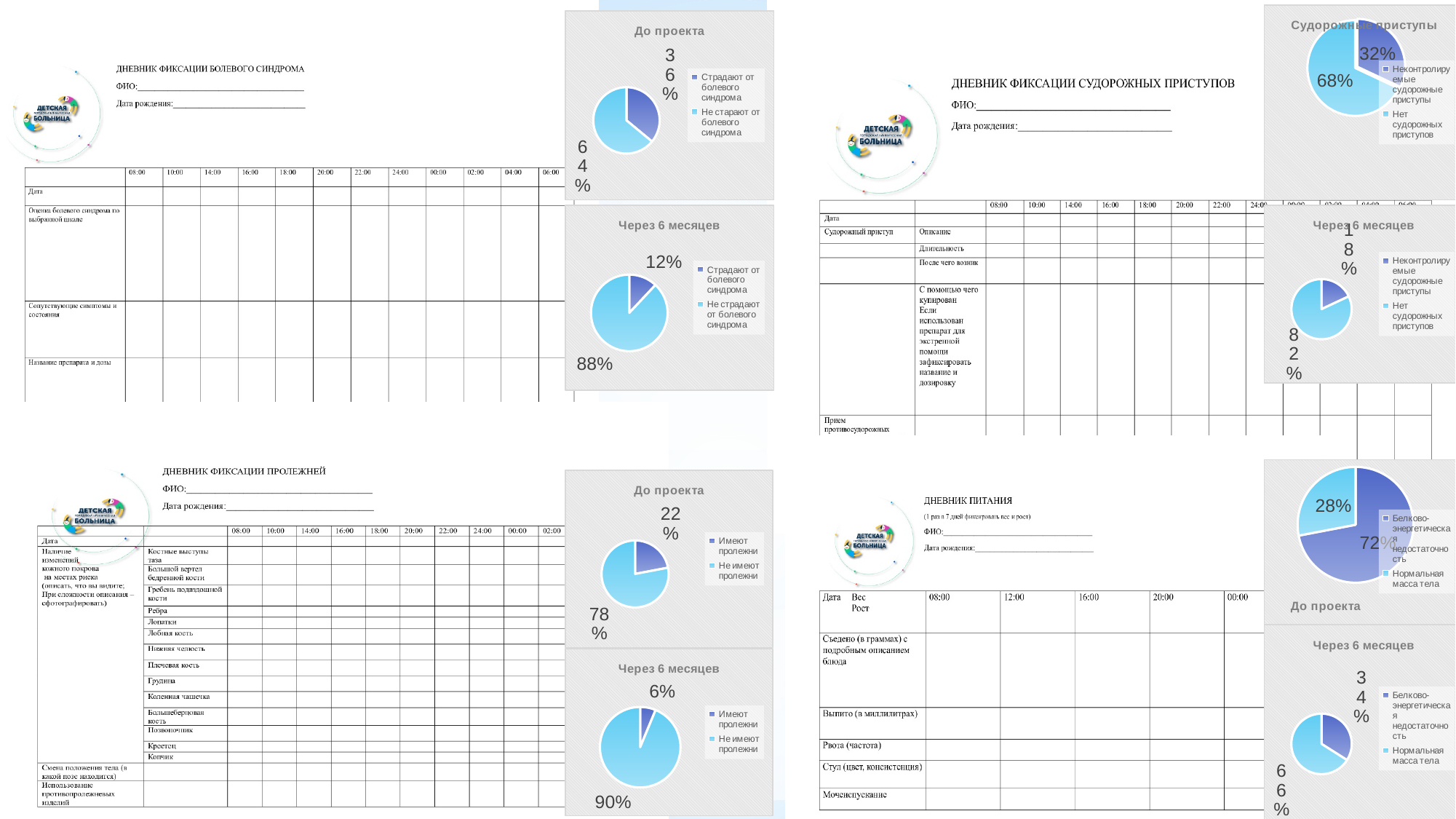
What type of chart is used for the 'Судорожные приступы' chart at the top-right of the slide? Pie chart In the 'До проекта' pie chart next to the nutrition diary (bottom-right of the slide), which category is the smallest? Нормальная масса тела How many entries does the legend list in the 'До проекта' pie chart next to the pain syndrome diary (top-left of the slide)? 2 In the 'Через 6 месяцев' pie chart next to the pressure sore diary (bottom-left of the slide), what share is labelled 'Не имеют пролежни'? 90% In the 'До проекта' pie chart next to the pressure sore diary (bottom-left of the slide), what share is labelled 'Имеют пролежни'? 22% In the 'Через 6 месяцев' pie chart next to the pain syndrome diary (top-left of the slide), what share is labelled 'Не страдают от болевого синдрома'? 88% In the 'Через 6 месяцев' pie chart next to the seizure diary (top-right of the slide), what share is labelled 'Нет судорожных приступов'? 82% In the 'Через 6 месяцев' pie chart next to the nutrition diary (bottom-right of the slide), which category is the largest? Нормальная масса тела In the 'До проекта' pie chart next to the nutrition diary (bottom-right of the slide), what share is labelled 'Белково-энергетическая недостаточность'? 72% In the 'До проекта' pie chart next to the pain syndrome diary (top-left of the slide), what share is labelled 'Страдают от болевого синдрома'? 36% What is the difference between the 'Страдают от болевого синдрома' share in the 'До проекта' chart and in the 'Через 6 месяцев' chart next to the pain syndrome diary (top-left of the slide)? 24% In the 'Судорожные приступы' pie chart (top-right of the slide), what share is labelled 'Неконтролируемые судорожные приступы'? 32%